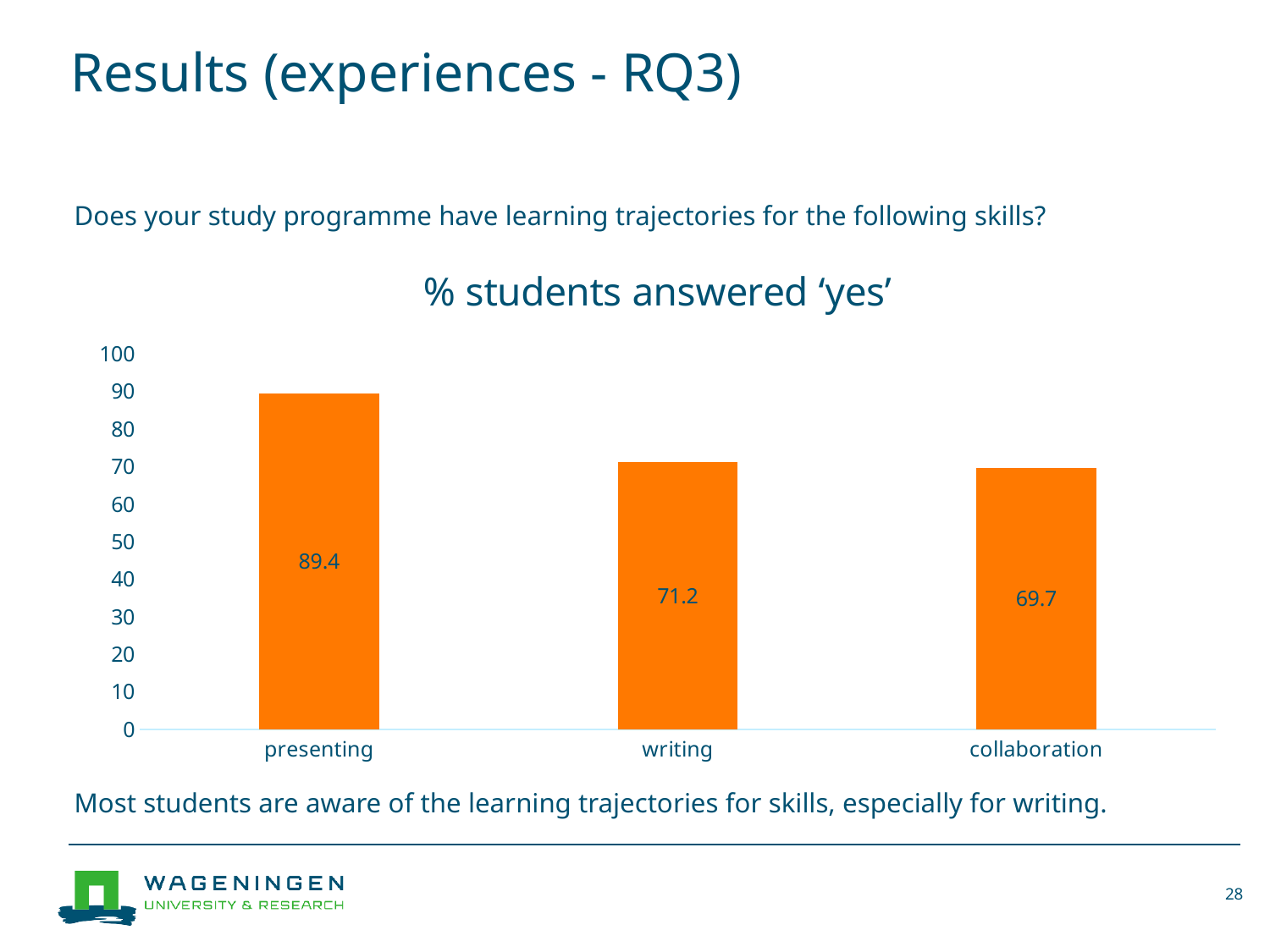
What percentage of students answered 'yes' for writing? 71.2 How many skills are shown on the chart? 3 Which is larger, the value for presenting or the value for collaboration? presenting Is the value for presenting greater or less than 80? greater What is the difference between the values for presenting and writing? 18.2 What percentage of students answered 'yes' for presenting? 89.4 What is the difference between the values for writing and collaboration? 1.5 Which skill has the highest percentage of students answering 'yes'? presenting What kind of chart is shown on the slide? bar chart Which skill has the lowest percentage of students answering 'yes'? collaboration What percentage of students answered 'yes' for collaboration? 69.7 What is the title of the chart? % students answered 'yes'